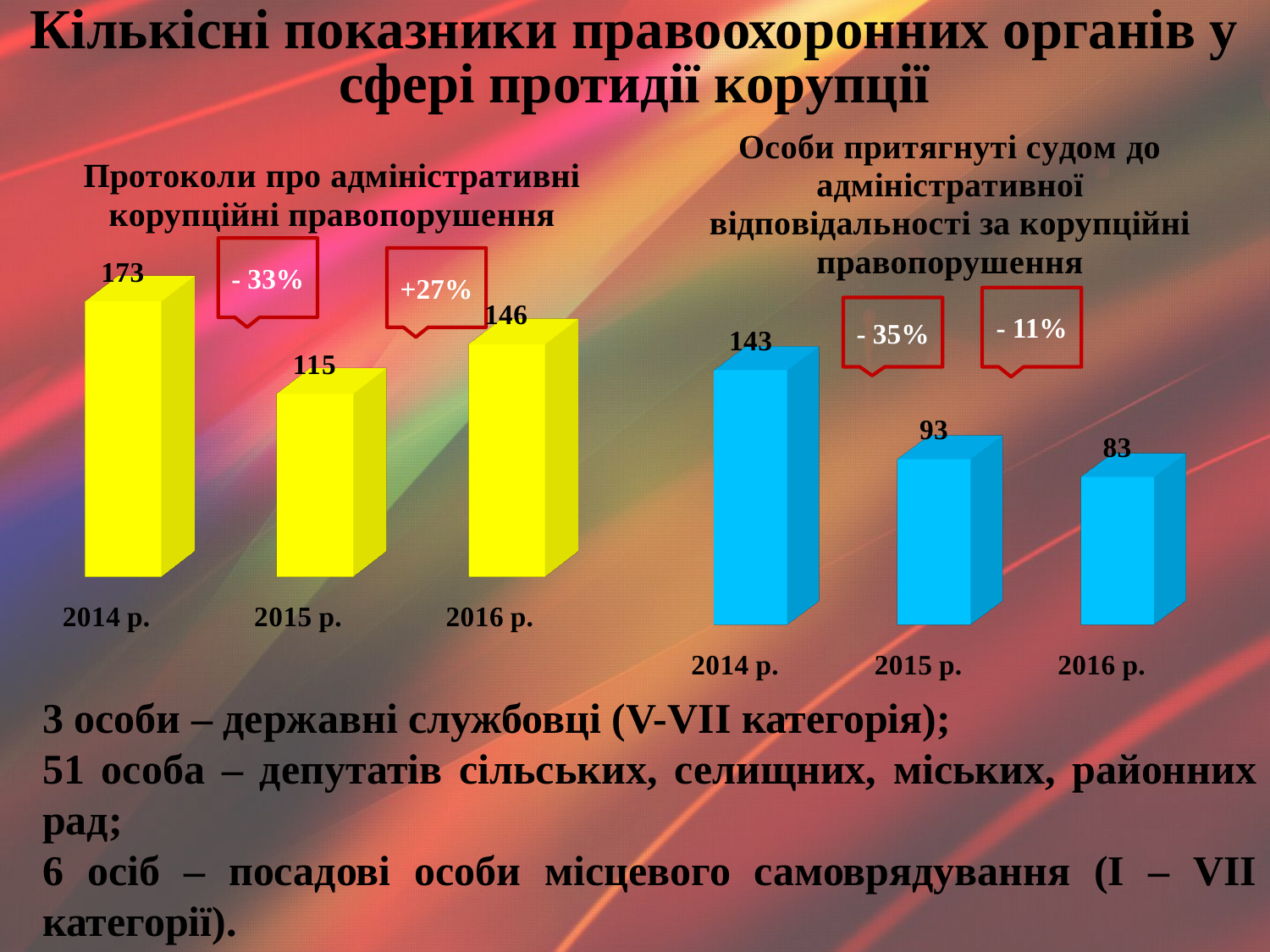
In the left chart (Протоколи про адміністративні корупційні правопорушення), what is the difference between the 2014 р. and 2015 р. values? 58 In the left chart (Протоколи про адміністративні корупційні правопорушення), what is the value for 2015 р.? 115 What kind of chart is the left chart (Протоколи про адміністративні корупційні правопорушення)? bar chart In the right chart (Особи притягнуті судом до адміністративної відповідальності), do the values rise or fall from 2014 р. to 2016 р.? fall In the left chart (Протоколи про адміністративні корупційні правопорушення), which year has the highest value? 2014 р. Which is larger: the 2016 р. value in the left chart or the 2016 р. value in the right chart? the left chart (146) In the right chart (Особи притягнуті судом до адміністративної відповідальності), which year has the lowest value? 2016 р. In the left chart (Протоколи про адміністративні корупційні правопорушення), what is the value for 2014 р.? 173 In the left chart (Протоколи про адміністративні корупційні правопорушення), how many bars are plotted? 3 In the right chart (Особи притягнуті судом до адміністративної відповідальності), what is the value for 2016 р.? 83 In the right chart (Особи притягнуті судом до адміністративної відповідальності), what is the difference between the 2014 р. and 2016 р. values? 60 In the right chart (Особи притягнуті судом до адміністративної відповідальності), what is the value for 2015 р.? 93